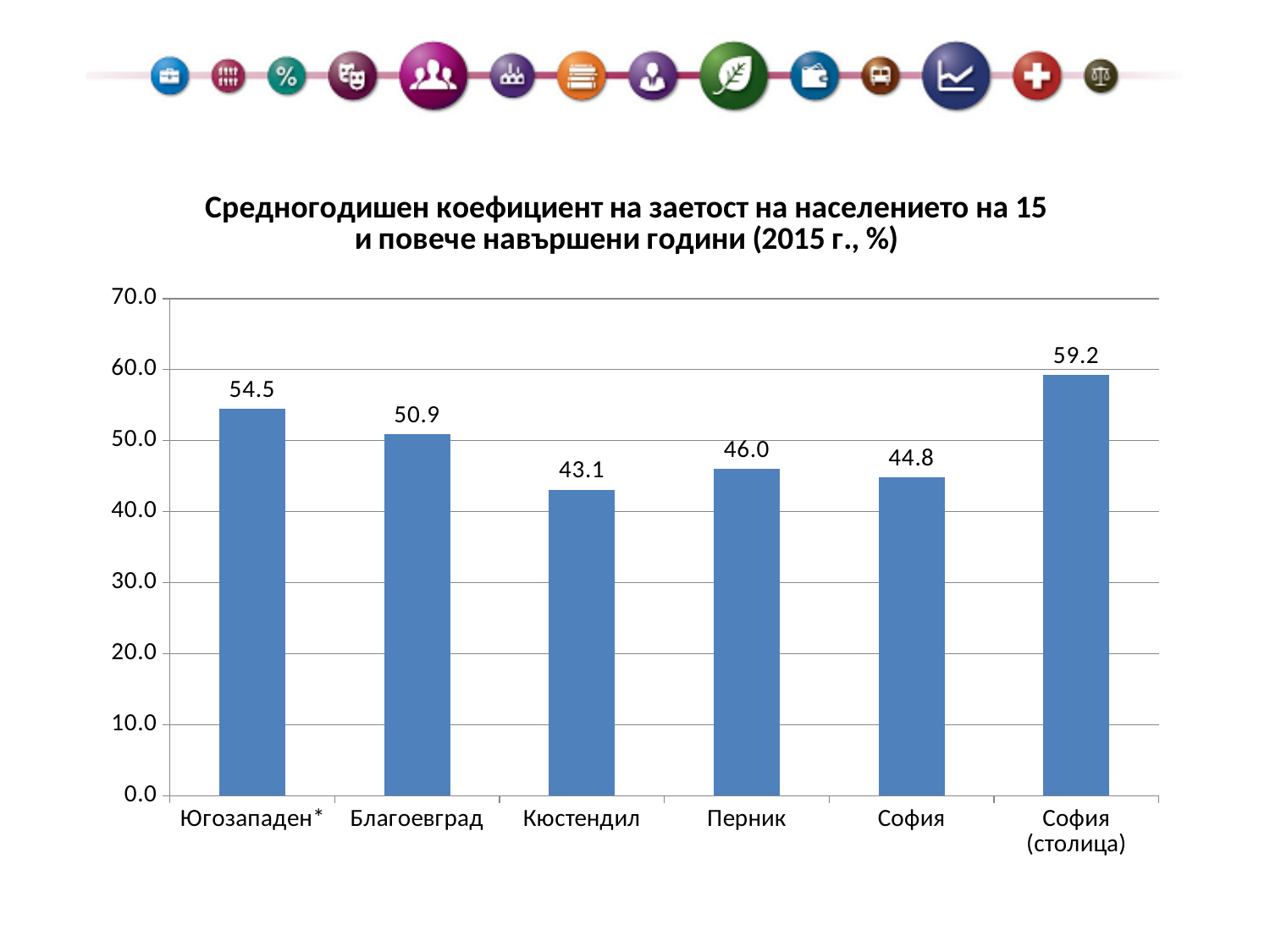
What is the difference between the values for Благоевград and Кюстендил? 7.8 What is the difference between the values for София (столица) and Югозападен*? 4.7 Which is larger, the value for Перник or the value for София? Перник What is the value for Кюстендил? 43.1 Is the value for Югозападен* greater or less than 50.0? greater Which category has the highest value? София (столица) Which category has the lowest value? Кюстендил What year does the chart title say the data is for? 2015 How many categories are shown on the x axis? 6 What is the value for Благоевград? 50.9 What is the value for София (столица)? 59.2 What kind of chart is shown on the slide? bar chart